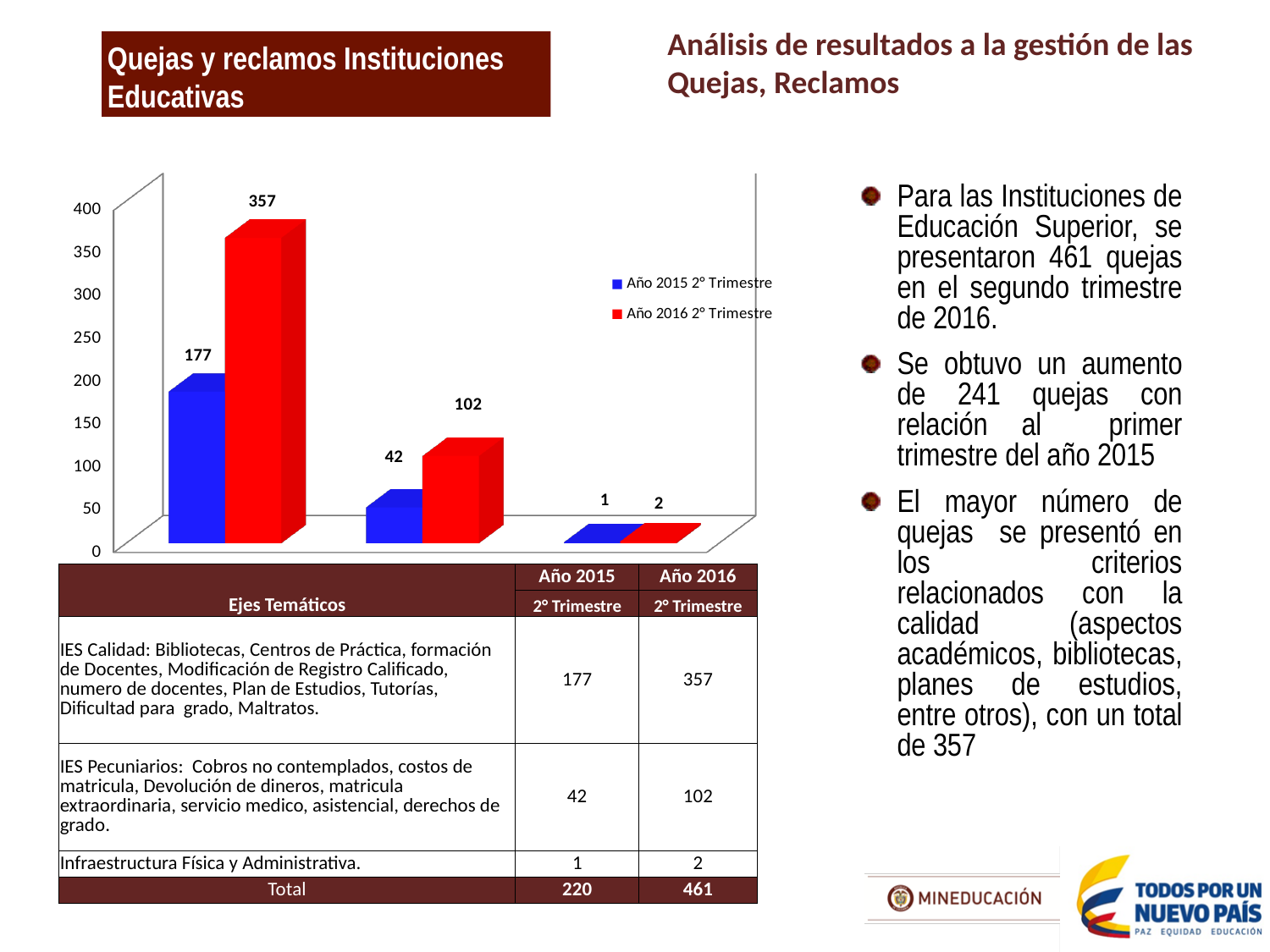
Which bar in the chart has the highest value? Año 2016 2° Trimestre in the first group (357) Which is larger in the second group of bars: Año 2015 2° Trimestre or Año 2016 2° Trimestre? Año 2016 2° Trimestre What is the value of the Año 2015 2° Trimestre bar in the third group of bars? 1 What is the value of the Año 2016 2° Trimestre bar in the second group of bars? 102 What is the difference between the Año 2016 2° Trimestre and Año 2015 2° Trimestre bars in the second group? 60 What is the difference between the Año 2016 2° Trimestre and Año 2015 2° Trimestre bars in the first group? 180 How many groups of bars are plotted in the chart? 3 How many series does the chart legend list? 2 What is the value of the red bar (Año 2016 2° Trimestre) in the first group of bars? 357 What is the value of the blue bar (Año 2015 2° Trimestre) in the first group of bars? 177 What colour are the Año 2016 2° Trimestre bars in the chart? red What kind of chart is shown on the slide? bar chart